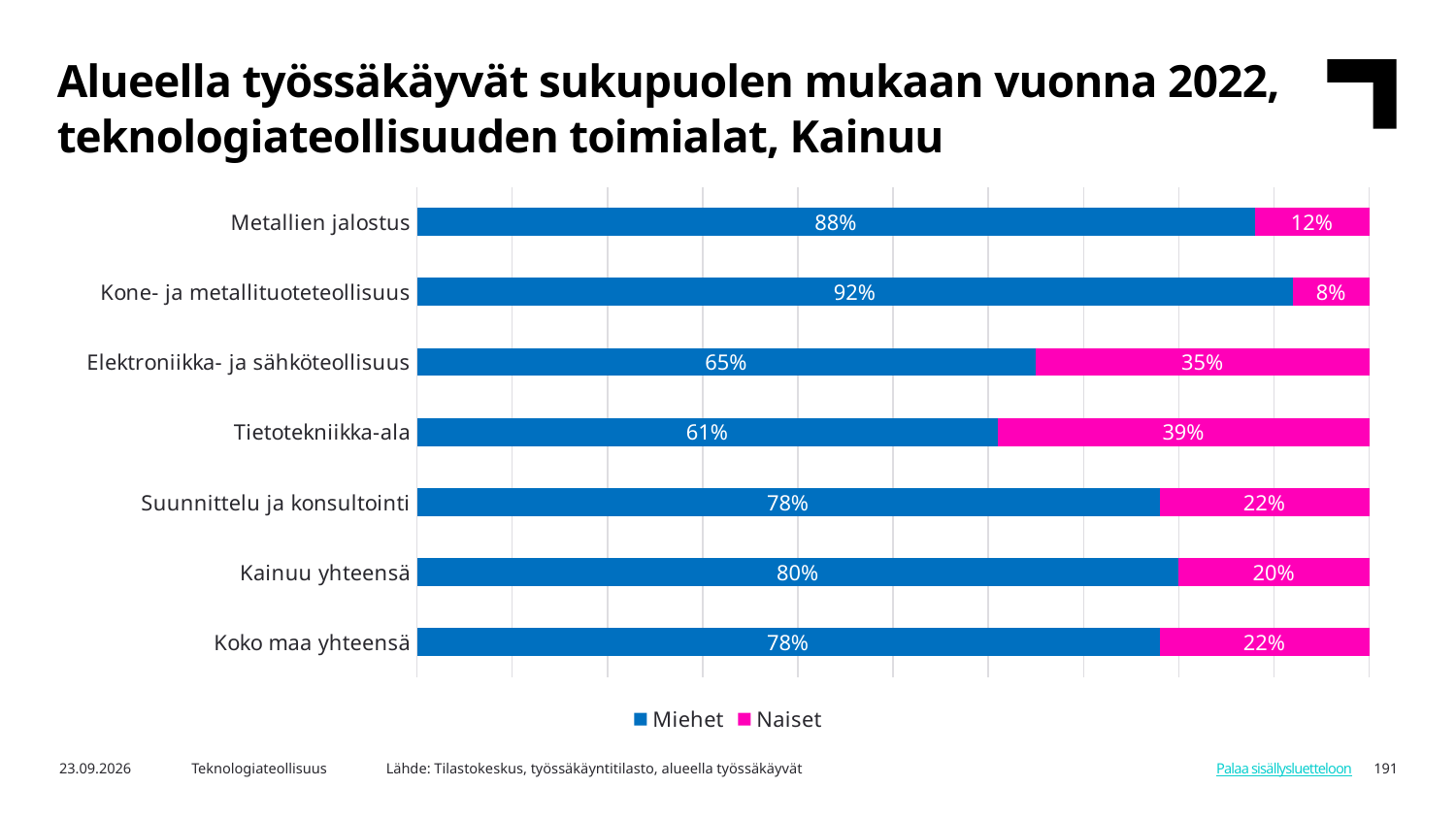
Which category has the lowest Miehet share? Tietotekniikka-ala What is the Naiset share for Tietotekniikka-ala? 39% What colour represents Naiset in the chart? Pink (magenta) How many categories are shown on the chart? 7 What kind of chart is shown on the slide? Stacked bar chart Which category has the highest Naiset share? Tietotekniikka-ala Which is larger: the Naiset share for Suunnittelu ja konsultointi or for Elektroniikka- ja sähköteollisuus? Elektroniikka- ja sähköteollisuus Which category has the lowest Naiset share? Kone- ja metallituoteteollisuus What is the Naiset share for Kainuu yhteensä? 20% What is the difference between the Miehet share for Metallien jalostus and for Elektroniikka- ja sähköteollisuus? 23 percentage points How many series does the legend list? 2 What is the Miehet share for Kone- ja metallituoteteollisuus? 92%